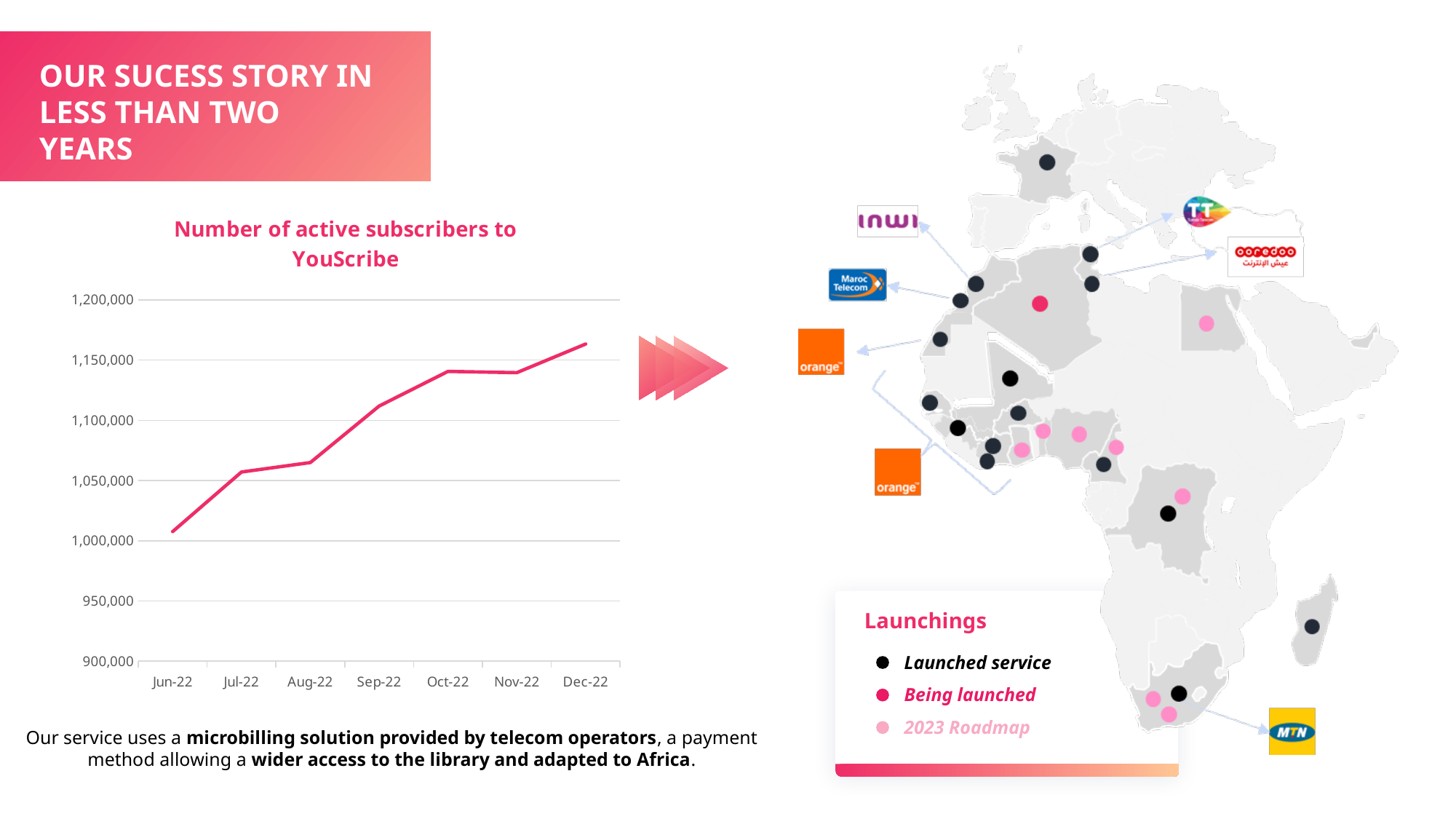
What is the title of the chart? Number of active subscribers to YouScribe Which is larger, the value for Sep-22 or the value for Jul-22? Sep-22 Which month has the lowest number of active subscribers? Jun-22 Do the number of active subscribers rise or fall from Jun-22 to Dec-22? rise What is the lowest value shown on the chart's y axis? 900,000 Is the value for Jun-22 greater or less than 1,050,000? less How many months are plotted on the x axis of the chart? 7 Which month has the highest number of active subscribers? Dec-22 Is the value for Oct-22 greater or less than 1,150,000? less Is the value for Aug-22 greater or less than 1,050,000? greater What kind of chart is shown on the slide? line chart